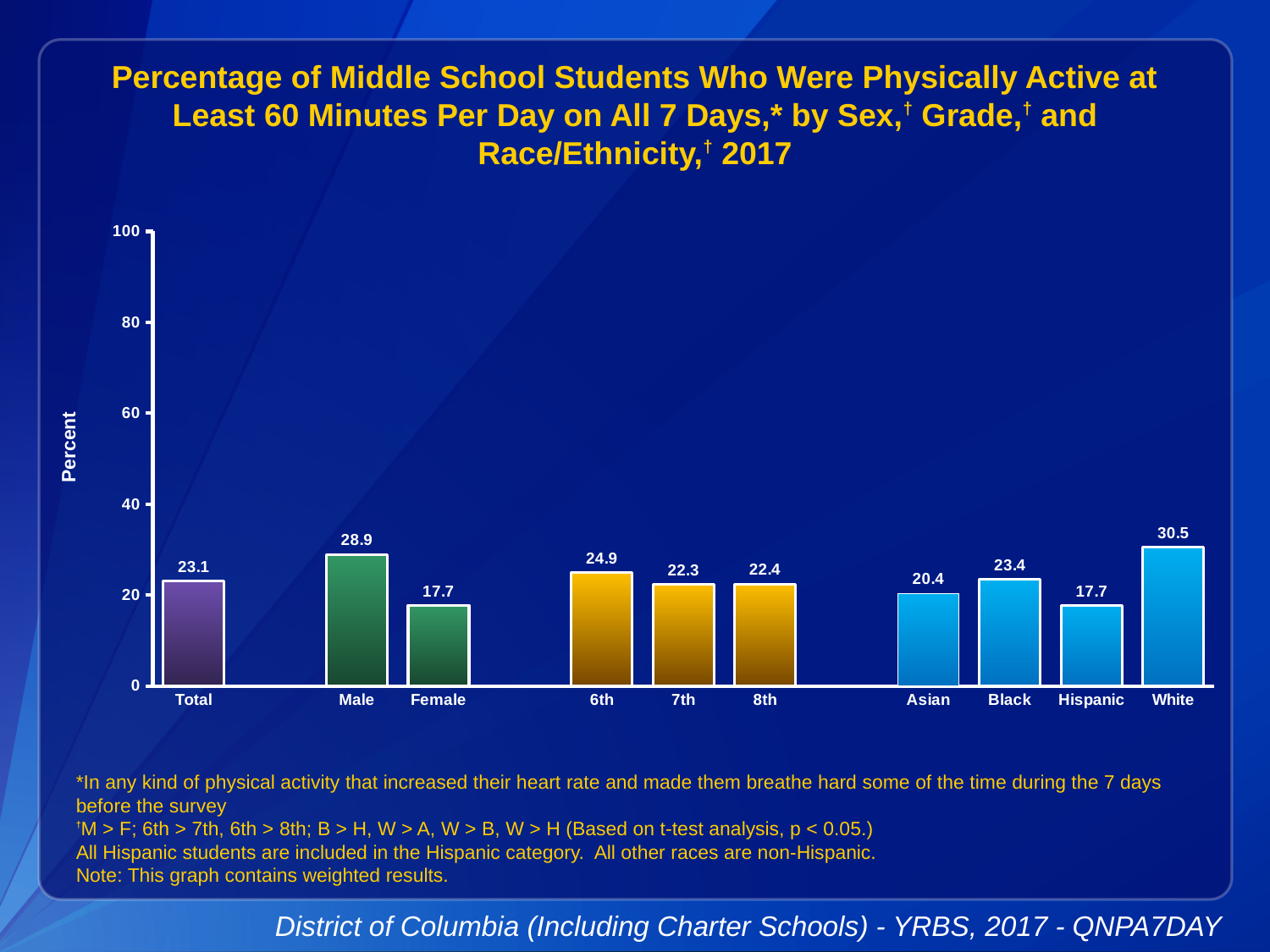
Is the value for White greater or less than 40? less Which category has the highest value? White Which is larger, the value for Black or the value for Asian? Black What is the value for Total? 23.1 What is the difference between the White and Hispanic values? 12.8 What is the difference between the Male and Female values? 11.2 What kind of chart is this? bar chart How many categories are shown on the x axis? 10 What is the value for 6th grade? 24.9 What is the value for Male? 28.9 Which grade has the lowest value? 7th What is the value for Asian? 20.4